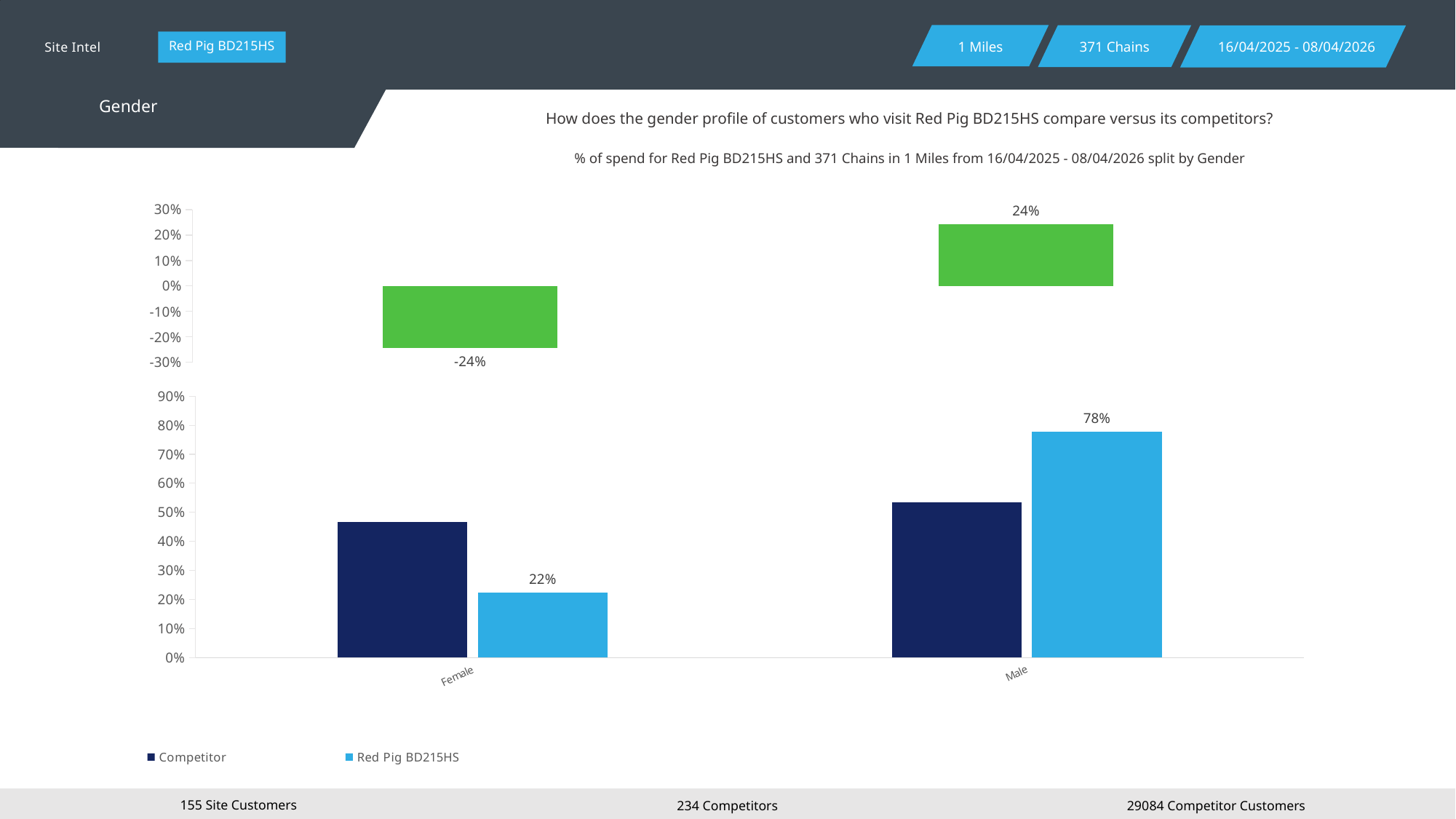
In the bottom chart, what is the difference between the Red Pig BD215HS values for Male and Female? 56% In the bottom chart, what is the value for Red Pig BD215HS in the Female category? 22% In the bottom chart, which category has the higher Red Pig BD215HS value, Female or Male? Male In the bottom chart, is the Competitor value for Male greater or less than 60%? less In the bottom chart, which series has the larger value in the Male category, Competitor or Red Pig BD215HS? Red Pig BD215HS In the bottom chart, is the Competitor value for Female greater or less than 40%? greater In the top chart, what is the value shown for the Male category? 24% How many categories are shown on the x axis of the bottom chart? 2 In the bottom chart, what is the value for Red Pig BD215HS in the Male category? 78% How many series does the legend of the bottom chart list? 2 In the top chart, what is the value shown for the Female category? -24% What type of chart is the bottom chart? Bar chart